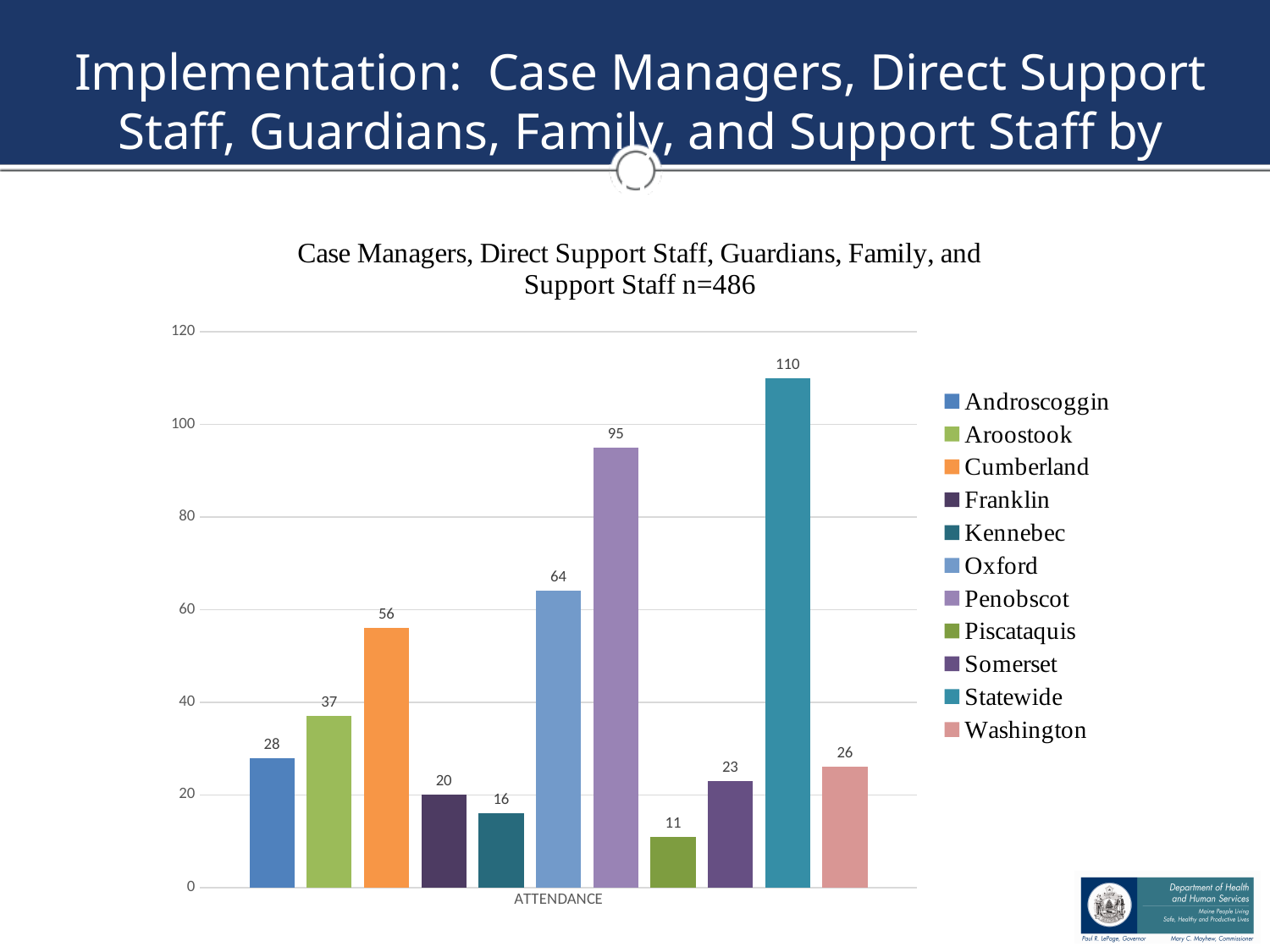
What is the attendance value for Piscataquis? 11 Which series has the highest attendance value? Statewide Which series has the lowest attendance value? Piscataquis Which is larger, the value for Franklin or the value for Somerset? Somerset Which is larger, the value for Androscoggin or the value for Washington? Androscoggin What is the attendance value for Penobscot? 95 How many series does the legend list? 11 What kind of chart is shown on the slide? Bar chart What is the difference between the Oxford value and the Aroostook value? 27 What is the attendance value for Cumberland? 56 What is the difference between the Statewide value and the Penobscot value? 15 What is the n value given in the chart title? n=486